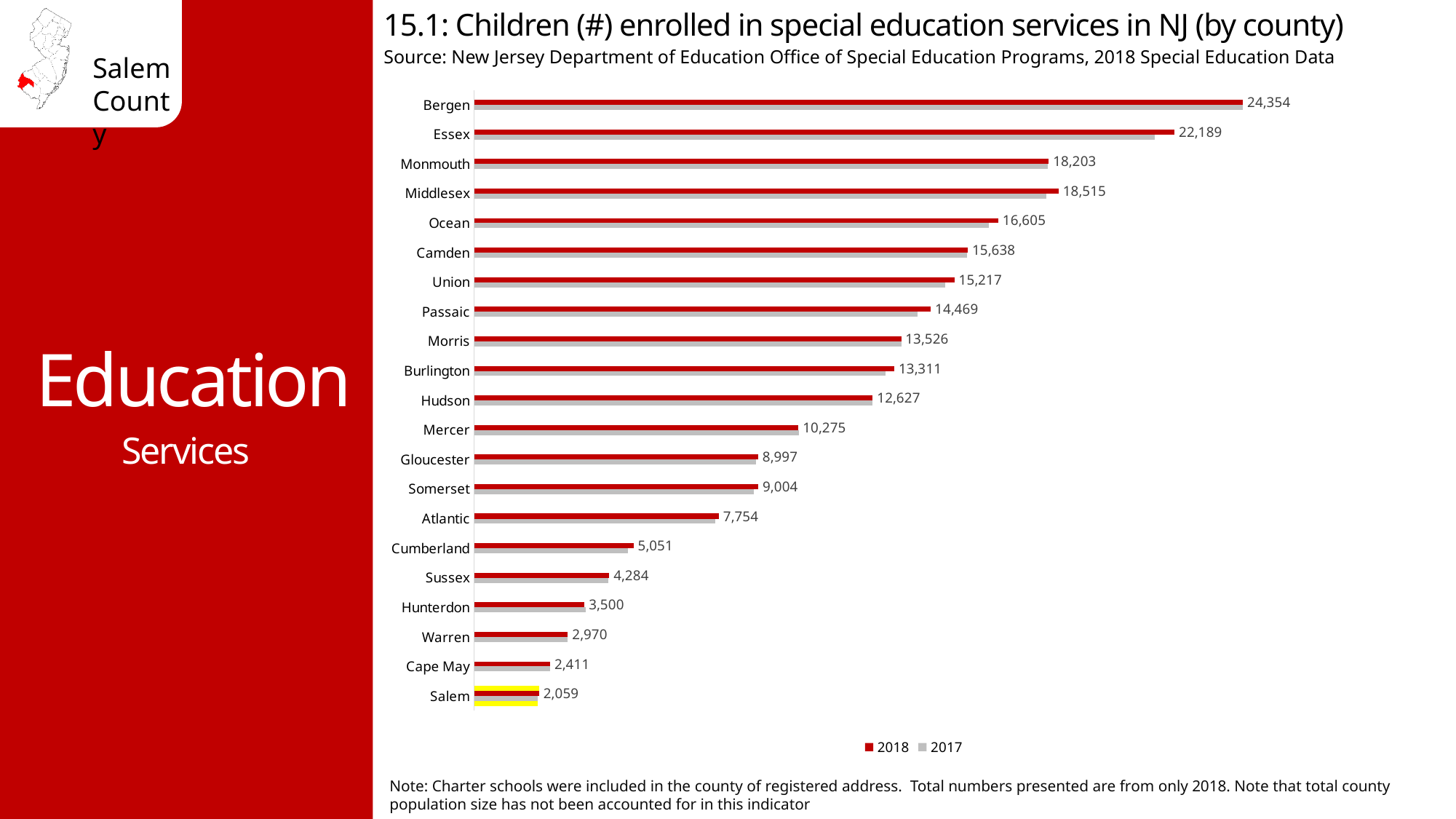
What is the difference between the 2018 values for Bergen and Essex? 2,165 How many series does the legend list? 2 What is the 2018 value for Camden? 15,638 What is the difference between the 2018 values for Cape May and Salem? 352 Which county has the highest 2018 value? Bergen Which has the larger 2018 value, Middlesex or Monmouth? Middlesex Which county has the lowest 2018 value? Salem How many counties are shown on the chart? 21 What kind of chart is shown? Bar chart What is the 2018 value for Salem? 2,059 What is the 2018 value for Bergen? 24,354 Which year is represented by the red bars? 2018